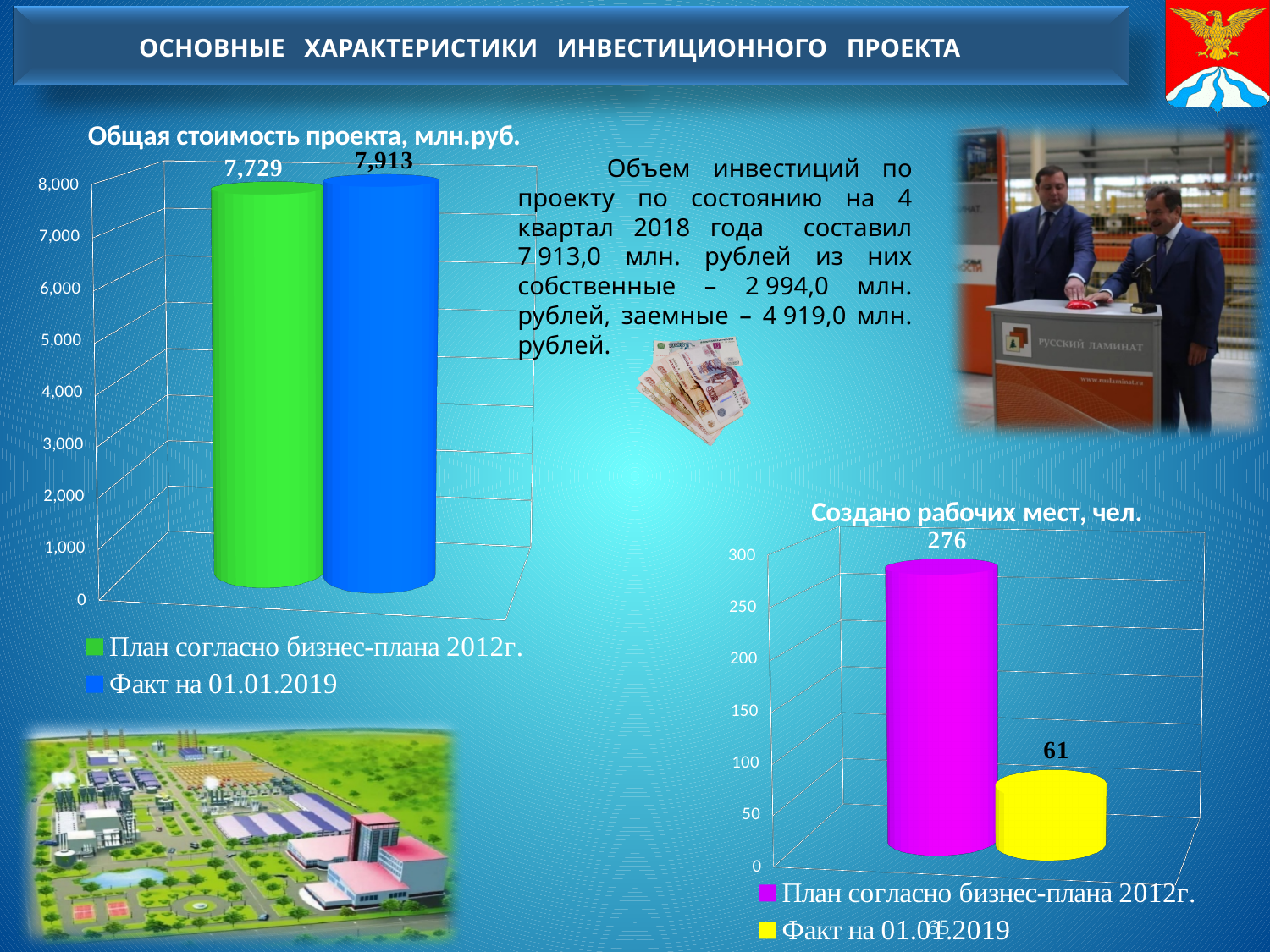
In the chart 'Общая стоимость проекта, млн.руб.', what is the value for 'Факт на 01.01.2019'? 7,913 In the chart 'Общая стоимость проекта, млн.руб.', what is the difference between the fact value and the plan value? 184 In the chart 'Создано рабочих мест, чел.', which series has the lowest value? Факт (yellow bar) In the chart 'Создано рабочих мест, чел.', is the value for 'План согласно бизнес-плана 2012г.' greater or less than 250? greater What kind of chart is 'Общая стоимость проекта, млн.руб.'? bar chart In the chart 'Общая стоимость проекта, млн.руб.', which series has the higher value? Факт на 01.01.2019 How many series does the legend of the chart 'Общая стоимость проекта, млн.руб.' list? 2 In the chart 'Создано рабочих мест, чел.', what is the value of the yellow 'Факт' bar? 61 In the chart 'Создано рабочих мест, чел.', what is the value for 'План согласно бизнес-плана 2012г.'? 276 In the chart 'Общая стоимость проекта, млн.руб.', what colour is the bar for 'План согласно бизнес-плана 2012г.'? green In the chart 'Общая стоимость проекта, млн.руб.', what is the value for 'План согласно бизнес-плана 2012г.'? 7,729 In the chart 'Создано рабочих мест, чел.', what is the difference between the plan value and the fact value? 215